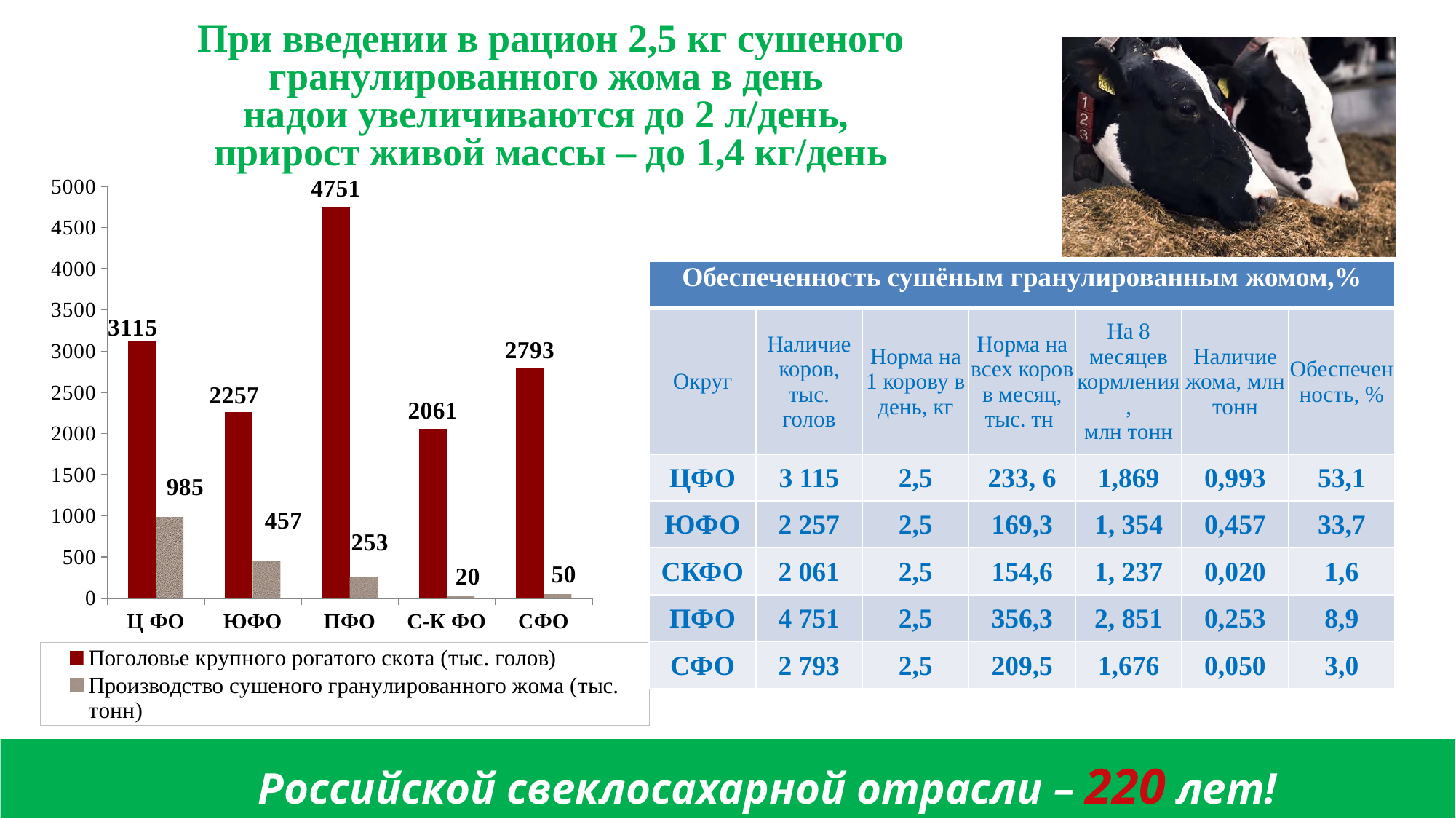
Which category has the lowest value for 'Производство сушеного гранулированного жома (тыс. тонн)'? С-К ФО What is the value of 'Поголовье крупного рогатого скота (тыс. голов)' for ПФО? 4751 How many categories are shown on the x axis of the chart? 5 What is the value of 'Производство сушеного гранулированного жома (тыс. тонн)' for С-К ФО? 20 Which category has the lowest value for 'Поголовье крупного рогатого скота (тыс. голов)'? С-К ФО Which category has the highest value for 'Поголовье крупного рогатого скота (тыс. голов)'? ПФО Which is larger: the 'Поголовье крупного рогатого скота (тыс. голов)' value for СФО or for ЮФО? СФО What is the value of 'Производство сушеного гранулированного жома (тыс. тонн)' for Ц ФО? 985 What type of chart is shown on the slide? Bar chart How many series does the chart legend list? 2 What is the difference between the 'Поголовье крупного рогатого скота (тыс. голов)' values for ПФО and Ц ФО? 1636 What is the difference between the 'Производство сушеного гранулированного жома (тыс. тонн)' values for ЮФО and ПФО? 204